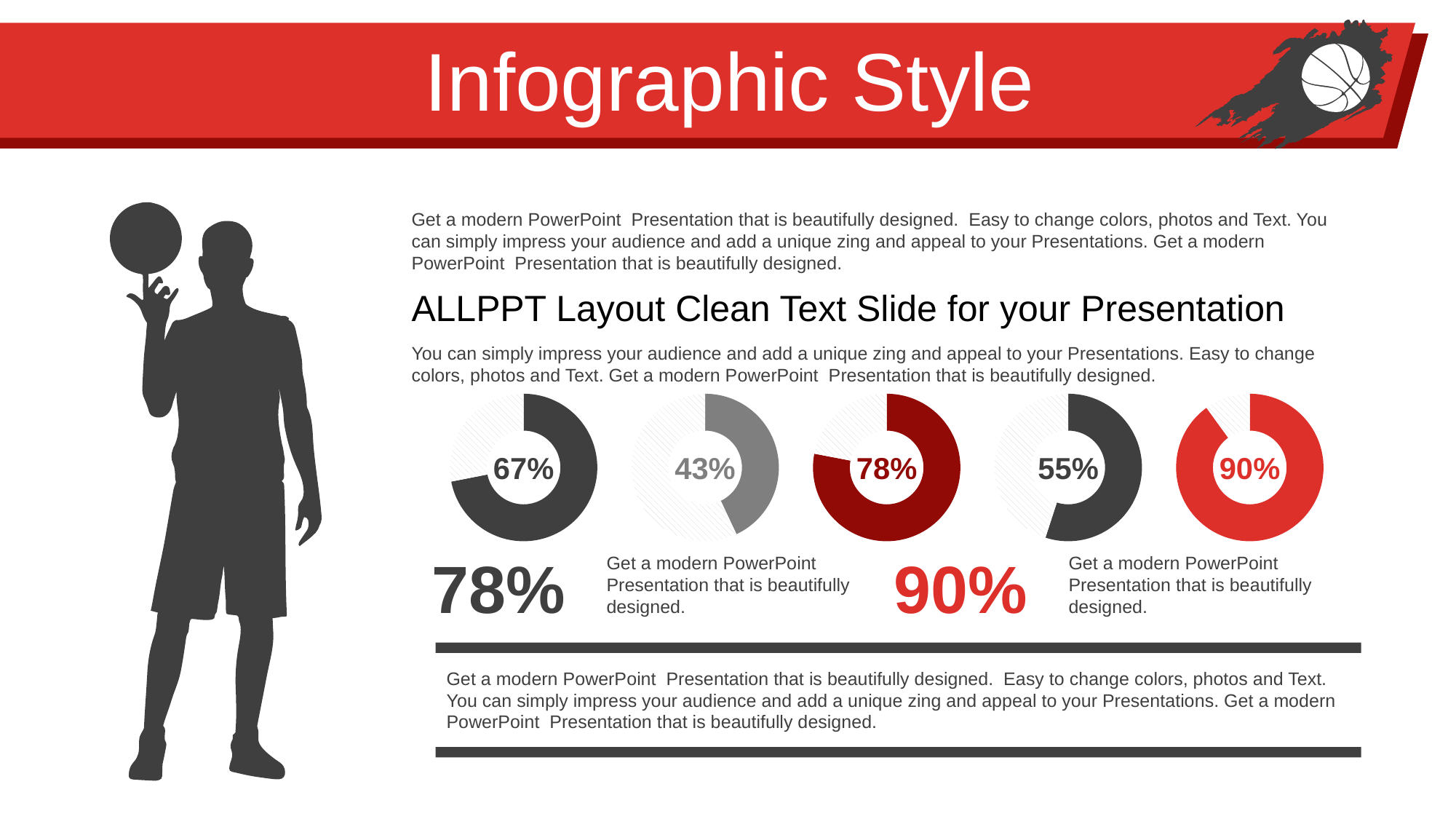
What percentage is shown in the leftmost donut chart? 67% What type of chart is used to display the percentages on the slide? Donut chart What is the difference between the percentages in the rightmost and leftmost donut charts? 23% Which is larger, the percentage in the third donut chart or the fourth donut chart? The third (78%) What percentage is shown in the fourth donut chart from the left? 55% What percentage is shown in the rightmost donut chart? 90% Which donut chart shows the lowest percentage? The second from the left (43%) What percentage is shown in the middle (third) donut chart? 78% What colour is the filled portion of the rightmost donut chart? Red How many donut charts are shown on the slide? 5 What percentage is shown in the second donut chart from the left? 43% Which donut chart shows the highest percentage? The rightmost one (90%)